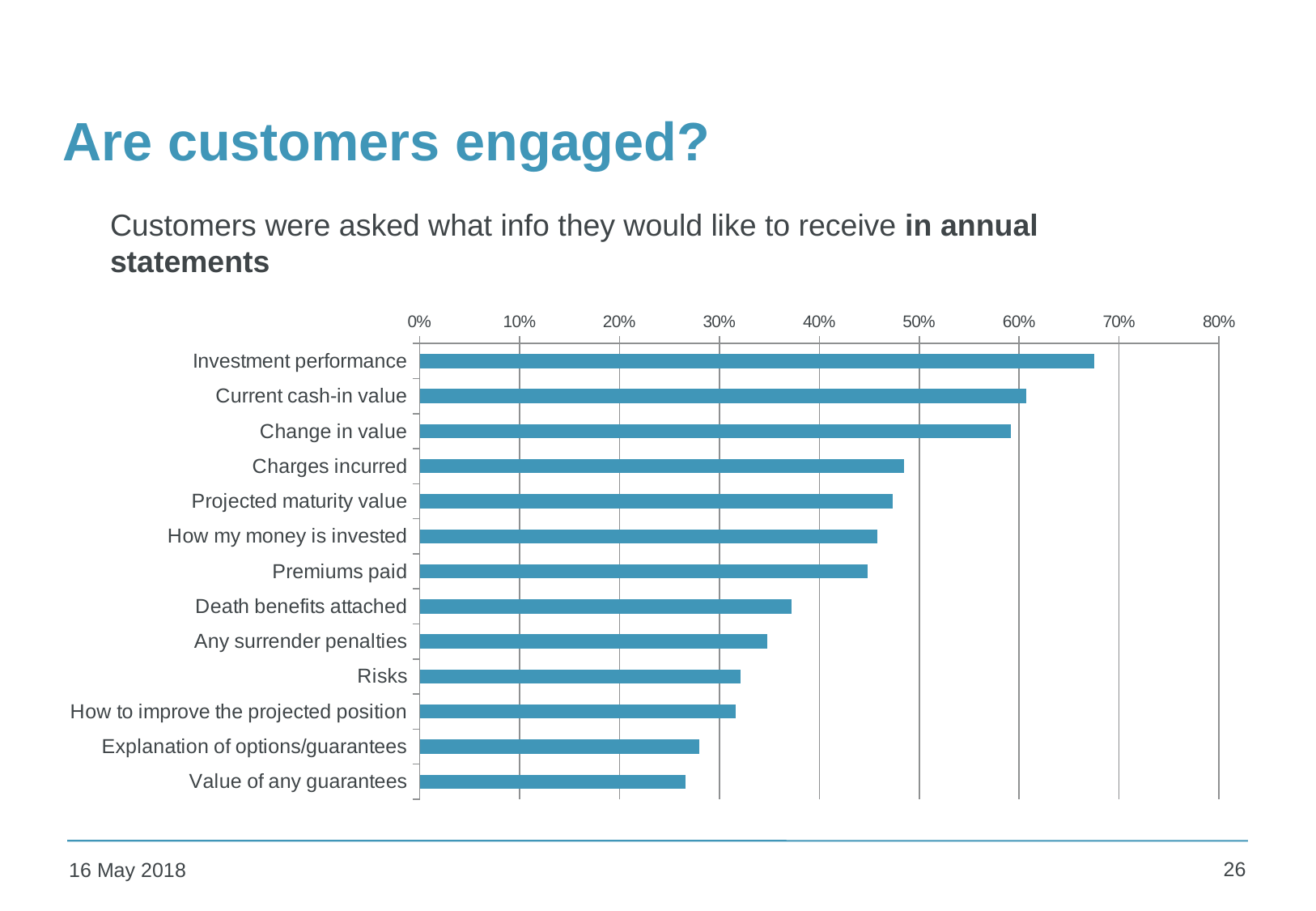
Which has a larger value, Current cash-in value or Premiums paid? Current cash-in value What is the title of the slide containing the chart? Are customers engaged? Which has a larger value, Death benefits attached or Explanation of options/guarantees? Death benefits attached Is the value for Value of any guarantees greater or less than 30%? less Is the value for Charges incurred greater or less than 40%? greater Is the value for Risks greater or less than 40%? less Which category has the highest value in the chart? Investment performance How many categories are plotted in the chart? 13 What kind of chart is shown on the slide? bar chart What is the highest percentage shown on the chart's axis? 80% Which category has the lowest value in the chart? Value of any guarantees